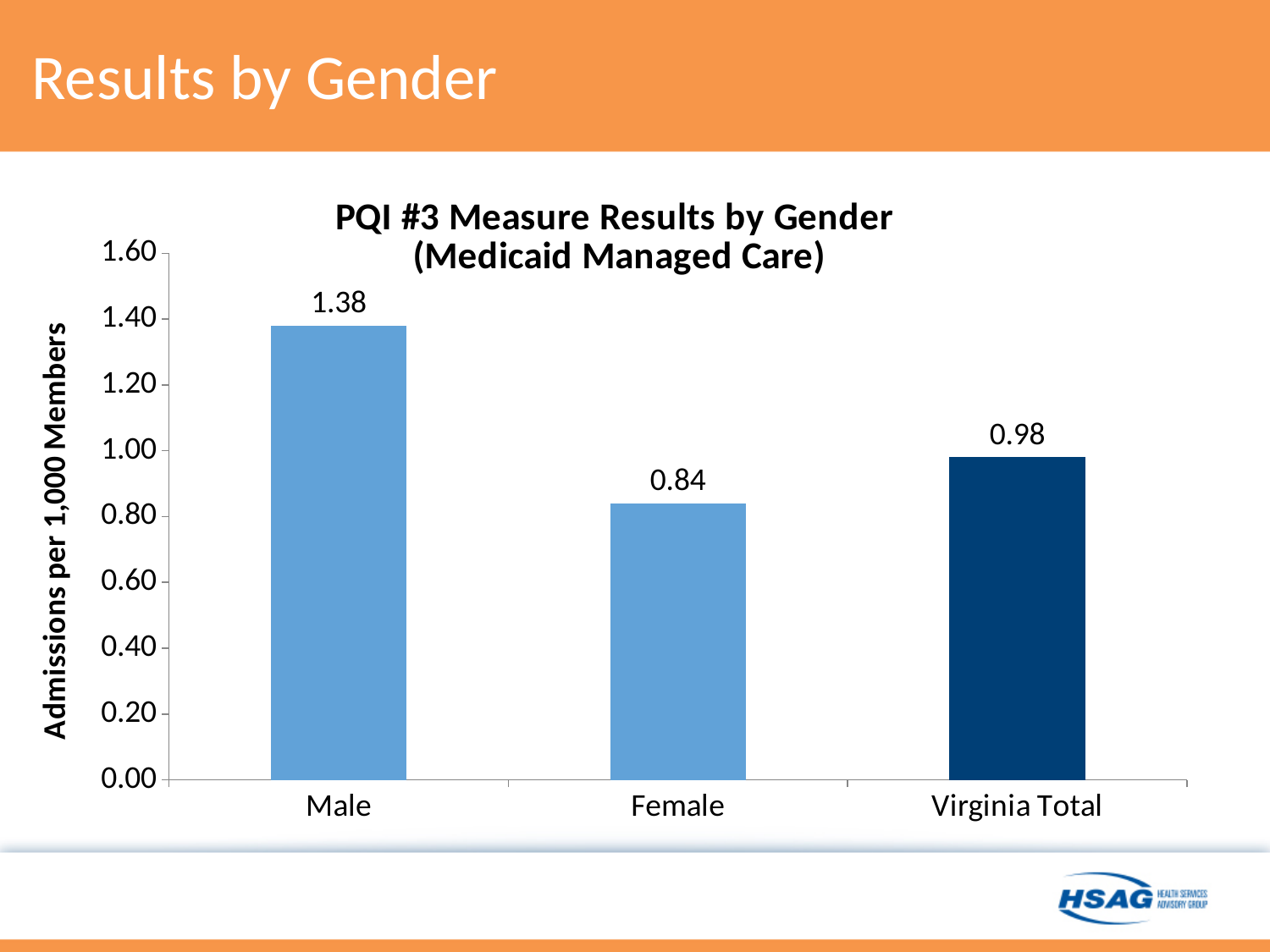
What is the value for Male? 1.38 What is the difference between the Male and Female values? 0.54 How many categories are shown on the x axis? 3 Which category has the highest value? Male What kind of chart is shown on the slide? bar chart Which category has the lowest value? Female Is the value for Male greater or less than 1.20? greater What is the label of the vertical axis? Admissions per 1,000 Members What is the value for Female? 0.84 What is the value for Virginia Total? 0.98 Which is larger, the value for Female or the value for Virginia Total? Virginia Total What is the difference between the Virginia Total and Female values? 0.14